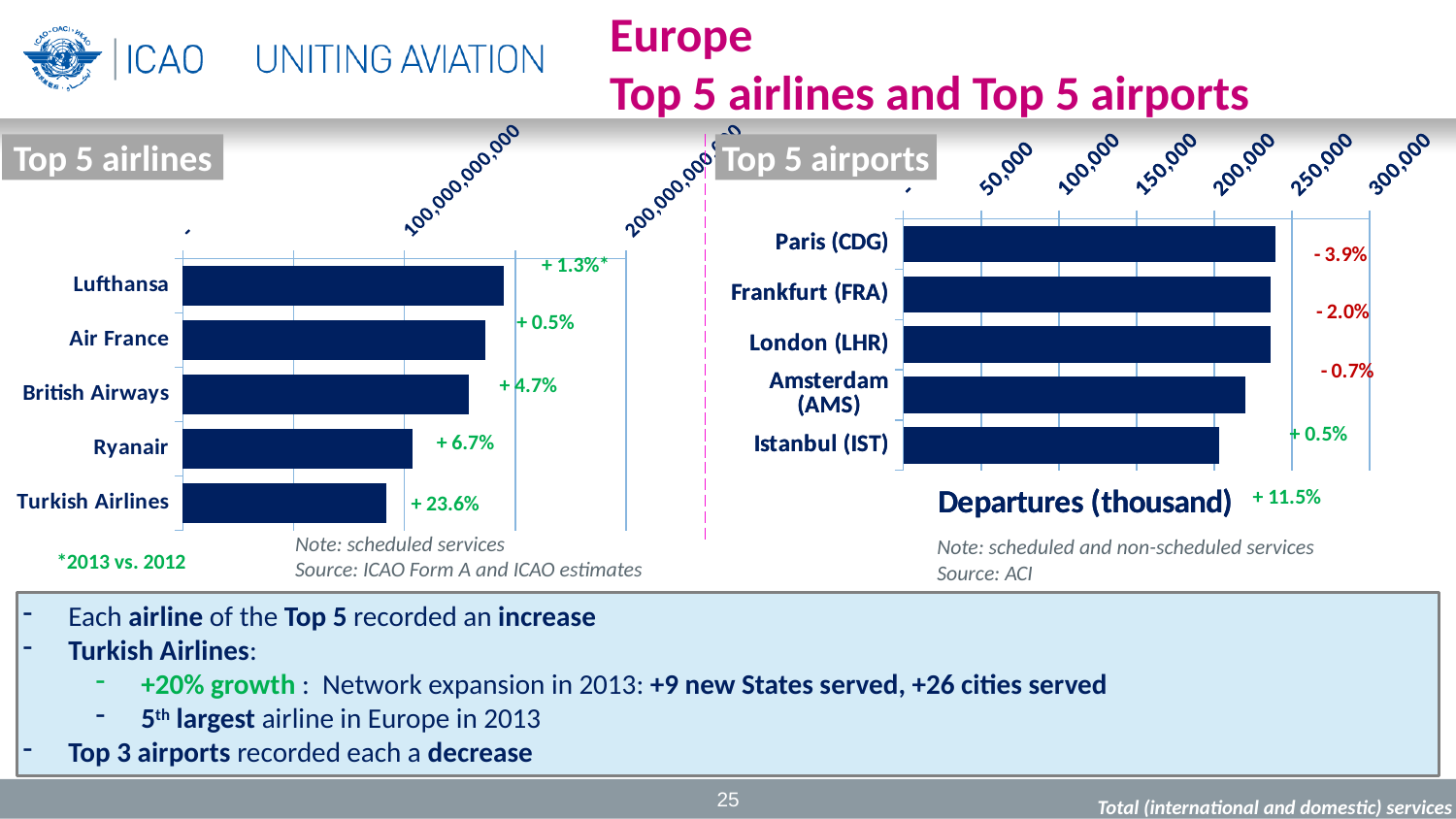
In the Top 5 airports chart, what percentage change is printed next to Paris (CDG)? - 3.9% What kind of chart is the Top 5 airports chart? bar chart In the Top 5 airports chart, is the value for Istanbul (IST) greater or less than 250,000? less In the Top 5 airlines chart, what growth percentage is printed next to Ryanair? + 6.7% In the Top 5 airlines chart, which airline has the longest bar? Lufthansa In the Top 5 airlines chart, which airline has the shortest bar? Turkish Airlines In the Top 5 airlines chart, how many airlines are shown? 5 In the Top 5 airlines chart, is the value for Lufthansa greater or less than 100,000,000? greater In the Top 5 airports chart, which airport has the shortest bar? Istanbul (IST) In the Top 5 airports chart, is the value for Paris (CDG) greater or less than 200,000? greater In the Top 5 airlines chart, what growth percentage is printed next to Turkish Airlines? + 23.6%